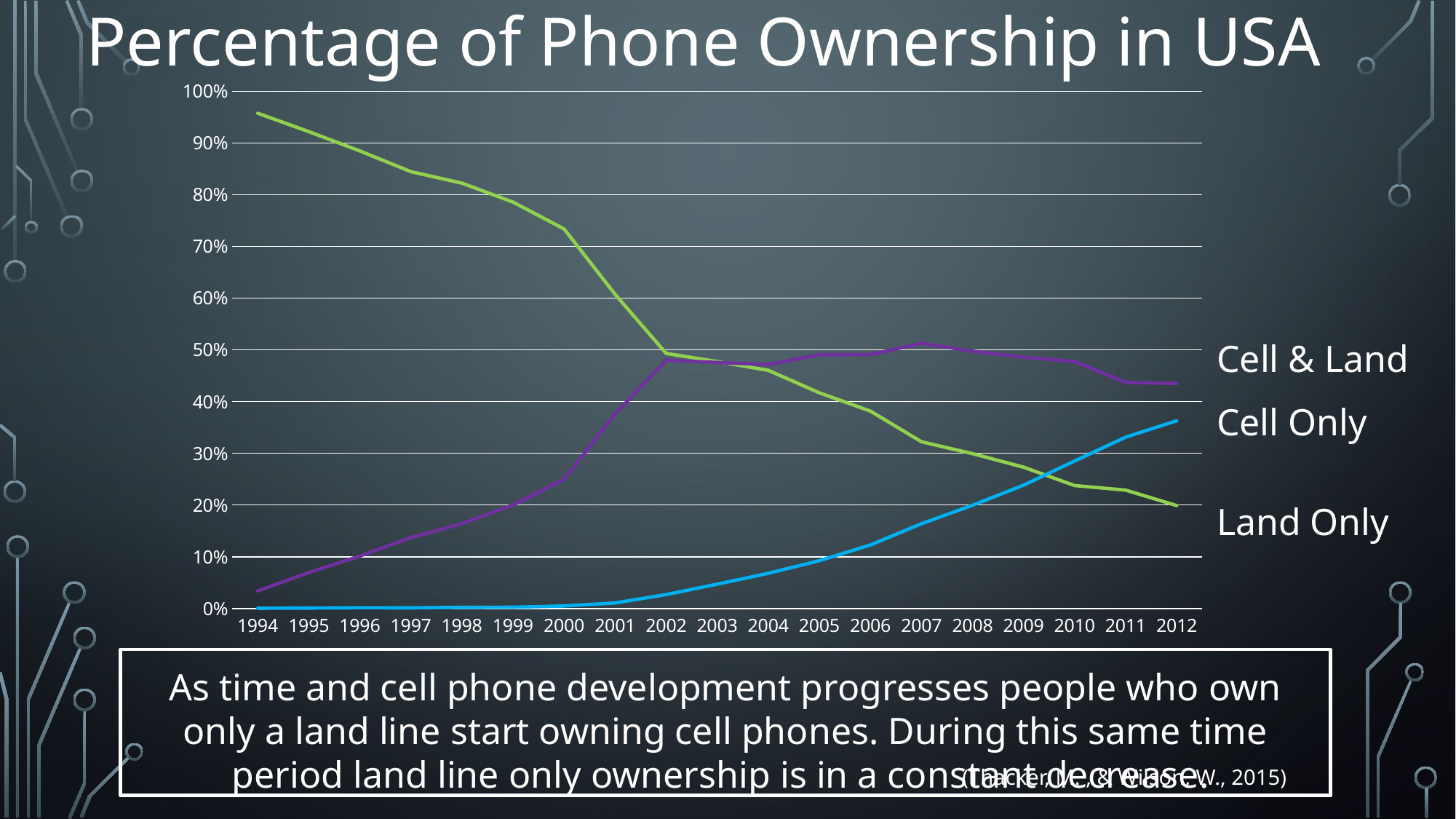
Which series is drawn in blue? Cell Only Does the Cell Only series rise or fall from 1994 to 2012? rise What kind of chart is shown on the slide? line chart In 2000, which is larger: Land Only or Cell & Land? Land Only In which year is the Cell Only value highest? 2012 How many series does the chart's legend list? 3 Is the Cell & Land value for 1994 greater or less than 10%? less Does the Land Only series rise or fall from 1994 to 2012? fall Is the Land Only value for 1994 greater or less than 90%? greater In which year is the Land Only value highest? 1994 What is the title of the chart? Percentage of Phone Ownership in USA How many years are plotted along the x axis? 19